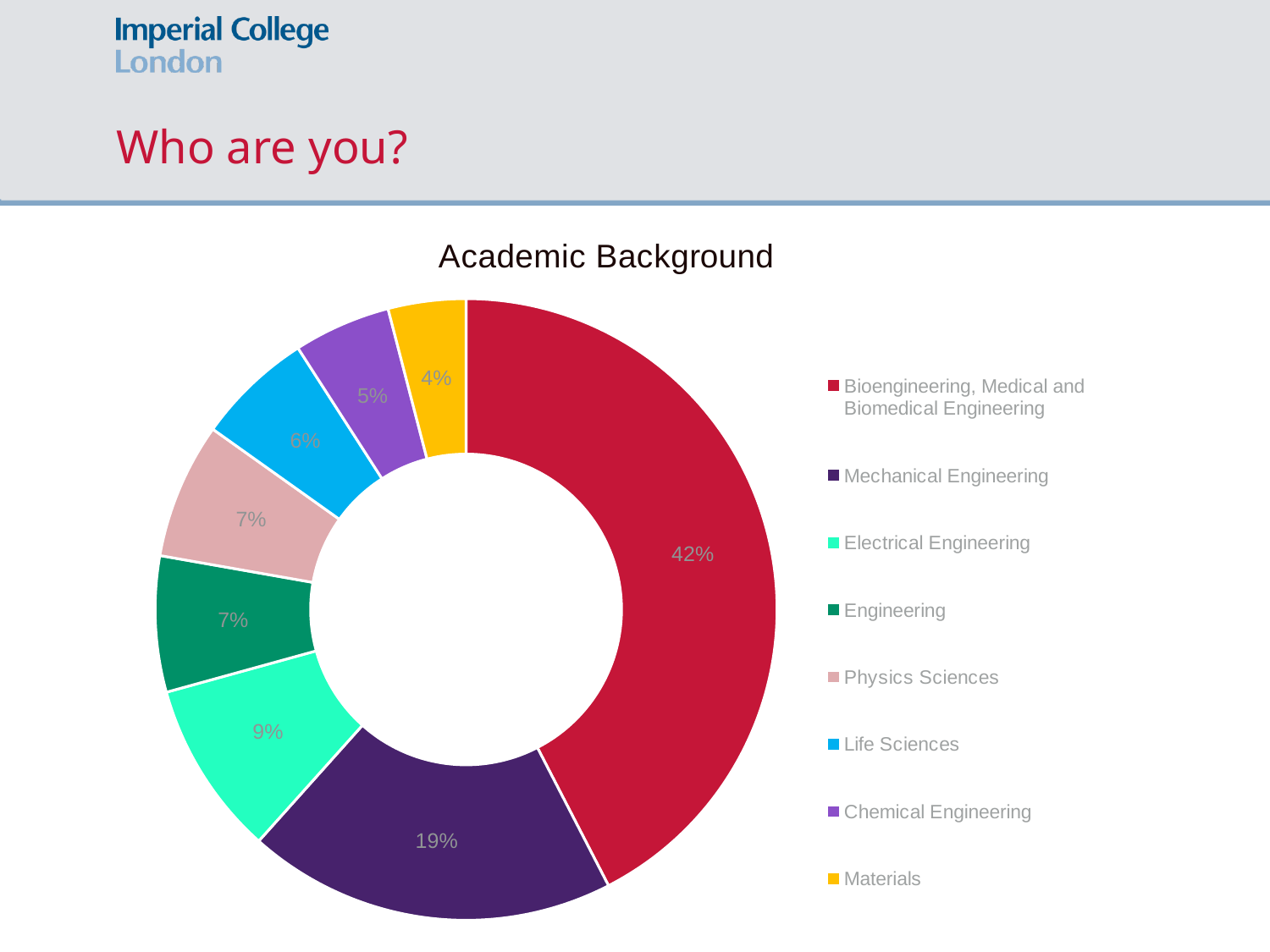
What share of the chart is Bioengineering, Medical and Biomedical Engineering? 42% Which is larger, the share for Life Sciences or the share for Chemical Engineering? Life Sciences What percentage is shown for Mechanical Engineering? 19% What percentage is shown for Materials? 4% What kind of chart is shown on the slide? Doughnut chart How many categories does the legend list? 8 Which category has the smallest share of the chart? Materials Which category has the largest share of the chart? Bioengineering, Medical and Biomedical Engineering What is the difference in percentage points between Bioengineering, Medical and Biomedical Engineering and Mechanical Engineering? 23 percentage points What percentage is shown for Physics Sciences? 7% What percentage is shown for Electrical Engineering? 9% What is the title of the chart? Academic Background